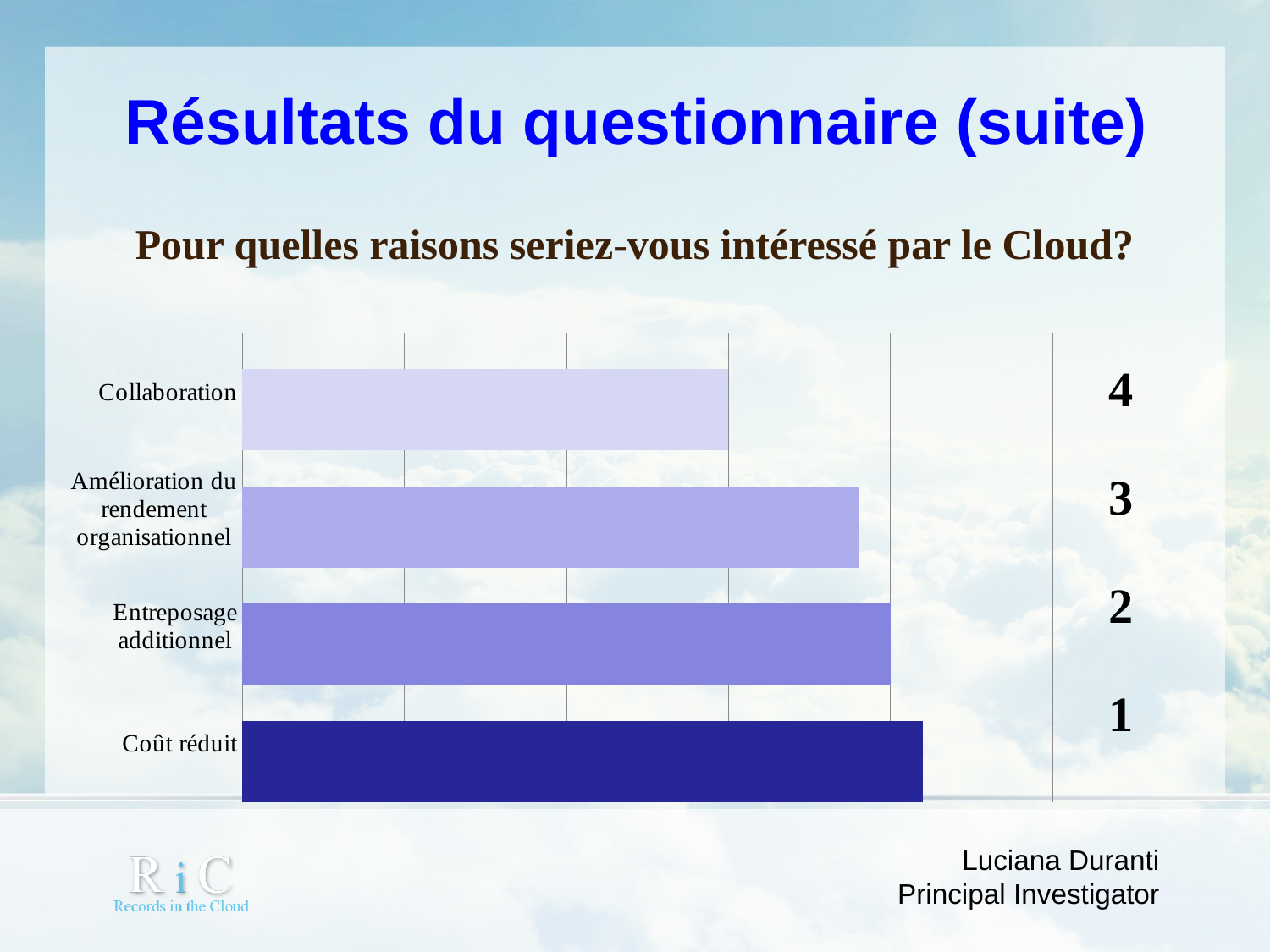
How many categories (reasons) are plotted in the chart? 4 Which bar is longer: Collaboration or Entreposage additionnel? Entreposage additionnel Which bar is longer: Collaboration or Amélioration du rendement organisationnel? Amélioration du rendement organisationnel Which category has the shortest bar in the chart? Collaboration Which category has the longest bar in the chart? Coût réduit Which bar is longer: Collaboration or Coût réduit? Coût réduit What kind of chart is shown on the slide? bar chart Which category is labelled with the rank number 1 on the right side of the chart? Coût réduit What question does the chart present the results for? Pour quelles raisons seriez-vous intéressé par le Cloud?